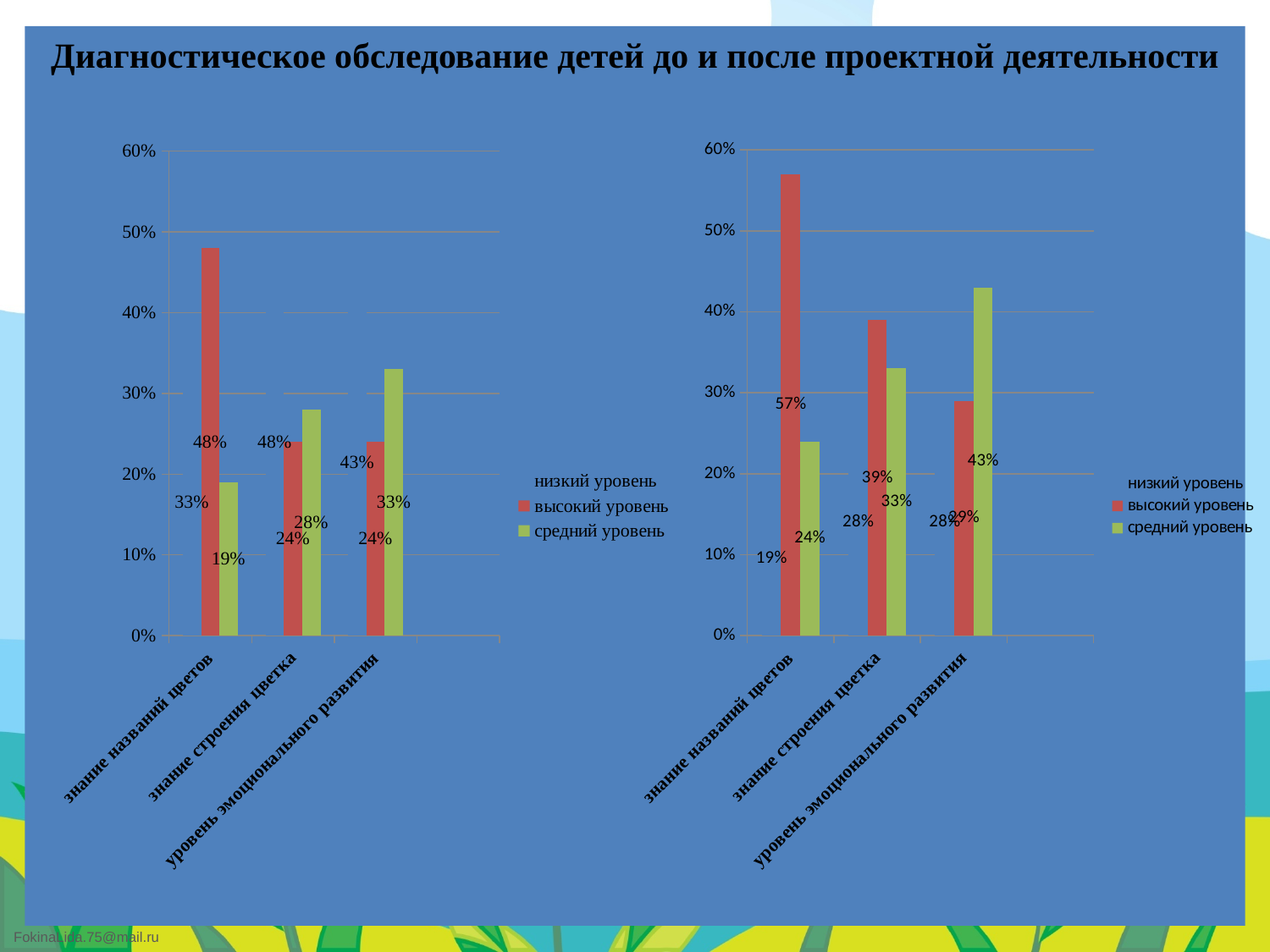
In the right chart, is the value of высокий уровень for знание названий цветов greater or less than 50%? greater In the left chart, for знание строения цветка, which is larger: высокий уровень or средний уровень? средний уровень In the right chart, what is the difference between высокий уровень and средний уровень for знание названий цветов? 33 percentage points How many categories are shown on the x axis of the left chart? 3 In the right chart, what is the value of высокий уровень for знание названий цветов? 57% In the left chart, what is the value of средний уровень for знание названий цветов? 19% How many series does the legend of the right chart list? 3 In the right chart, which category has the highest value for высокий уровень? знание названий цветов In the left chart, which category has the lowest value for средний уровень? знание названий цветов In the right chart, what is the value of средний уровень for уровень эмоционального развития? 43% What type of chart is the left chart? bar chart In the left chart, what is the value of высокий уровень for знание названий цветов? 48%